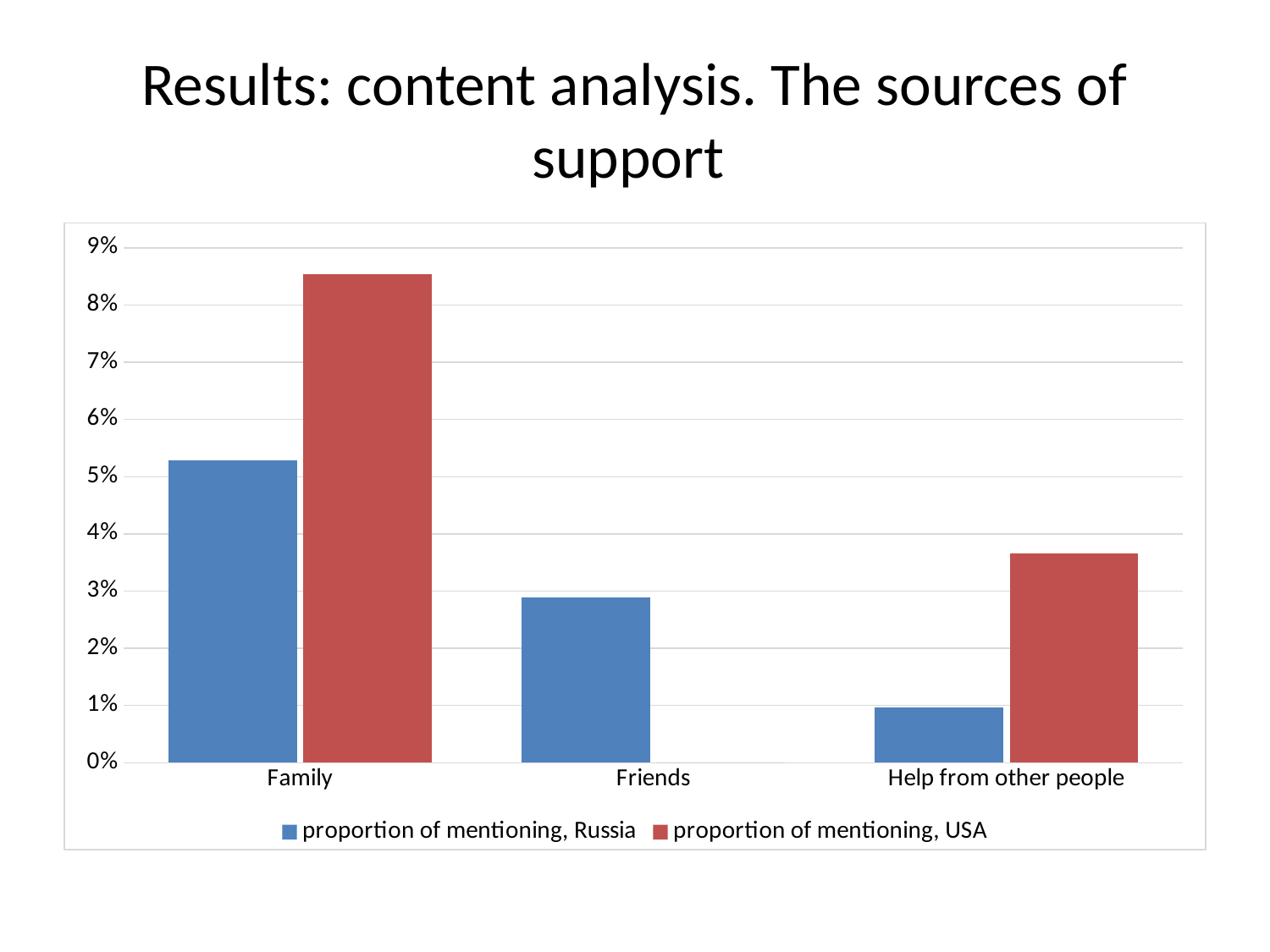
What colour are the bars for the series 'proportion of mentioning, USA'? red Which category has the highest value for the series 'proportion of mentioning, Russia'? Family Which category has the highest value for the series 'proportion of mentioning, USA'? Family Is the value for 'Help from other people' in the series 'proportion of mentioning, USA' greater or less than 4%? less What kind of chart is shown on the slide? bar chart Is the value for Family in the series 'proportion of mentioning, USA' greater or less than 8%? greater For the 'Help from other people' category, which series has the larger value: Russia or USA? proportion of mentioning, USA How many series does the chart's legend list? 2 How many categories are shown on the x axis of the chart? 3 Is the value for Friends in the series 'proportion of mentioning, Russia' greater or less than 2%? greater Which category has the lowest value for the series 'proportion of mentioning, Russia'? Help from other people For the Family category, which series has the larger value: 'proportion of mentioning, Russia' or 'proportion of mentioning, USA'? proportion of mentioning, USA